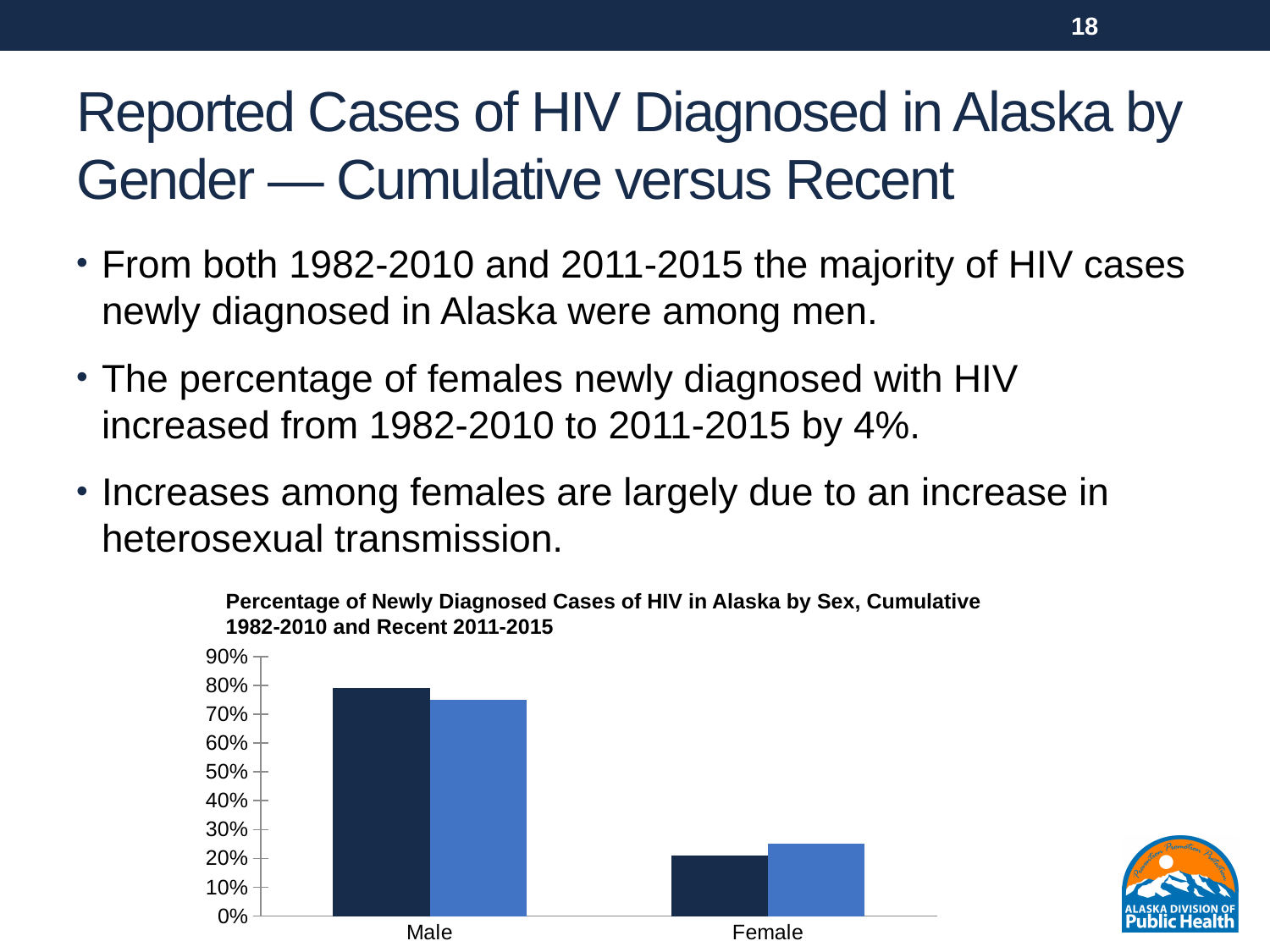
What is the highest tick value shown on the y axis of the chart? 90% Are the bars for Male greater or less than 60%? greater For the Female category, which bar is taller, the dark navy bar or the lighter blue bar? the lighter blue bar What is the title of the chart? Percentage of Newly Diagnosed Cases of HIV in Alaska by Sex, Cumulative 1982-2010 and Recent 2011-2015 Which category has higher values in the chart, Male or Female? Male Is the dark navy bar for Male greater or less than 70%? greater What kind of chart is shown on the slide? bar chart How many categories are shown on the x axis of the chart? 2 Is the lighter blue bar for Female greater or less than 20%? greater Which category has the shortest bars in the chart? Female Which category has the tallest bars in the chart? Male